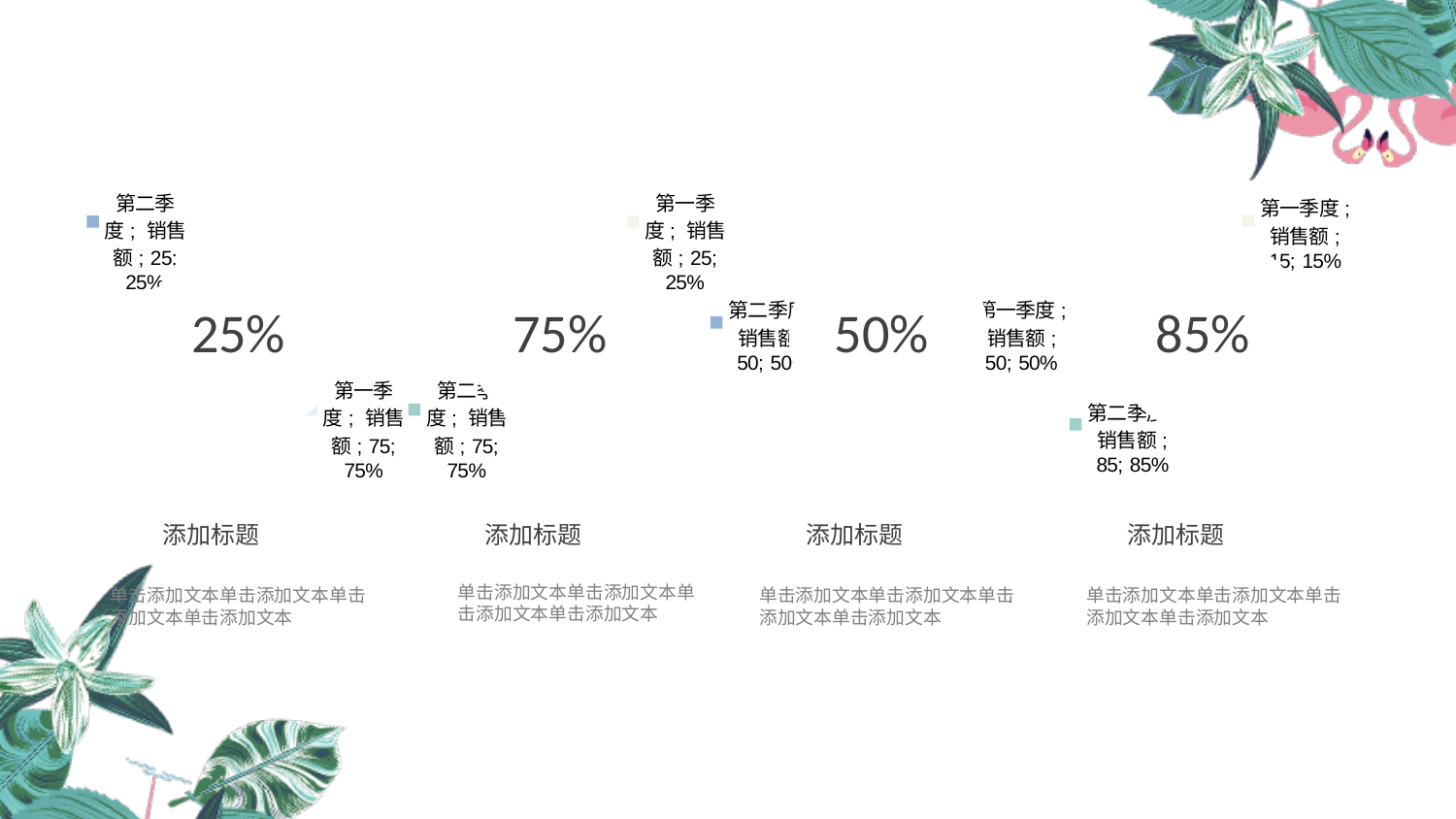
In the second chart from the left, what is the value labelled for 第二季度? 75 In the leftmost chart, what is the value labelled for 第二季度? 25 How many categories are labelled in the leftmost chart? 2 In the third chart from the left, what is the difference between the values for 第一季度 and 第二季度? 0 In the rightmost chart, what is the difference between the values for 第二季度 and 第一季度? 70 In the third chart from the left, what percentage is shown for 第一季度? 50% In the rightmost chart, which category has the highest value? 第二季度 In the rightmost chart, what percentage is shown for 第二季度? 85% In the rightmost chart, what is the value labelled for 第一季度? 15 In the leftmost chart, what percentage is shown for 第一季度? 75% In the second chart from the left, which category has the larger value, 第一季度 or 第二季度? 第二季度 What large percentage is displayed in the centre of the leftmost chart? 25%